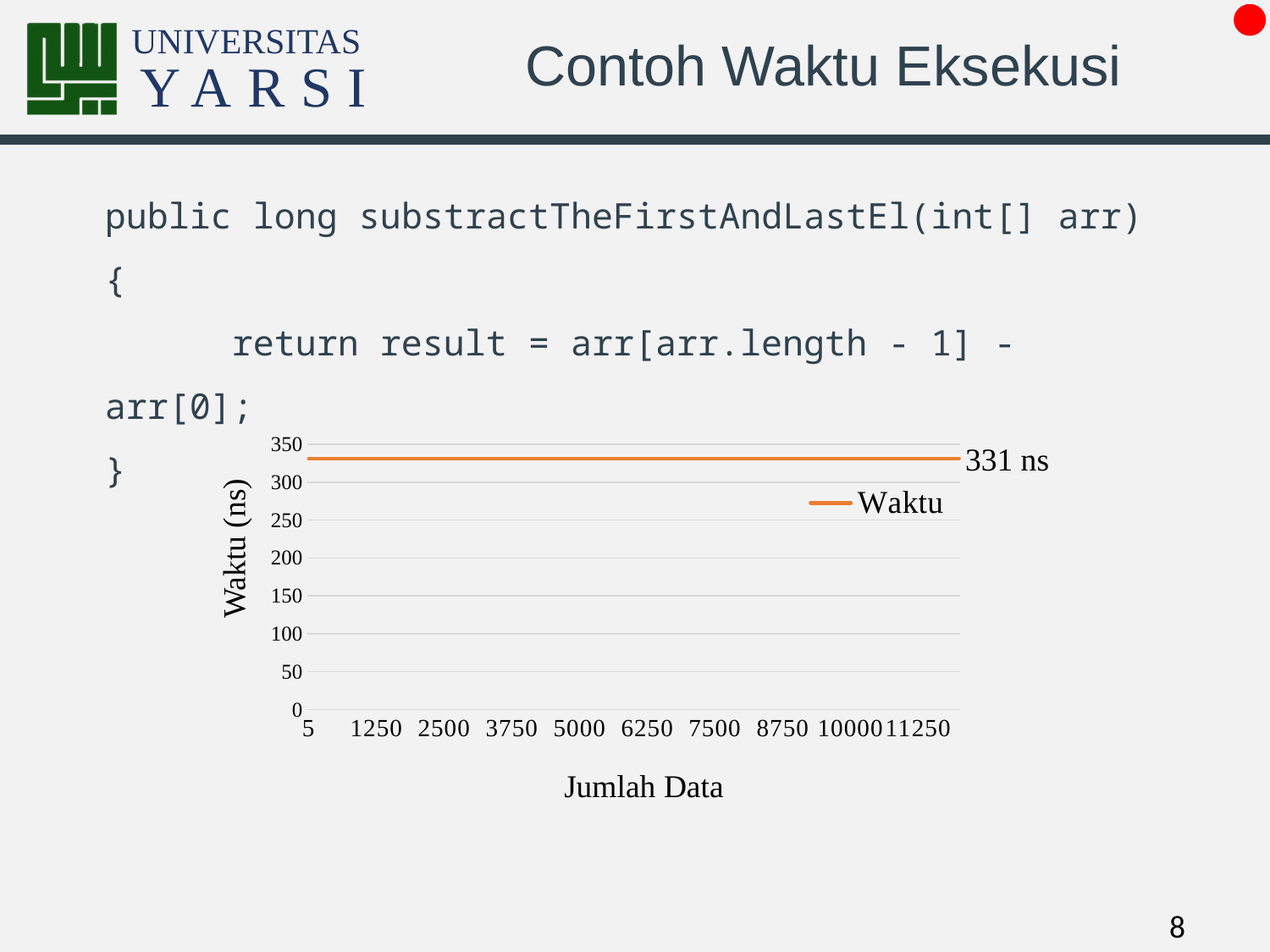
How many Jumlah Data tick labels are shown along the x axis of the chart? 10 Is the Waktu value at Jumlah Data 2500 greater or less than 350? less Is the Waktu value at Jumlah Data 5000 greater or less than 300? greater What kind of chart is shown on the slide? line chart What is the name of the series shown in the chart legend? Waktu What value is labelled at the end of the Waktu line, at Jumlah Data 11250? 331 ns What is the highest value shown on the y axis of the chart? 350 What is the first Jumlah Data value shown on the x axis? 5 How many series does the chart legend list? 1 What is the title of the y axis of the chart? Waktu (ns) Does the Waktu line rise, fall, or stay flat as Jumlah Data increases along the x axis? stays flat